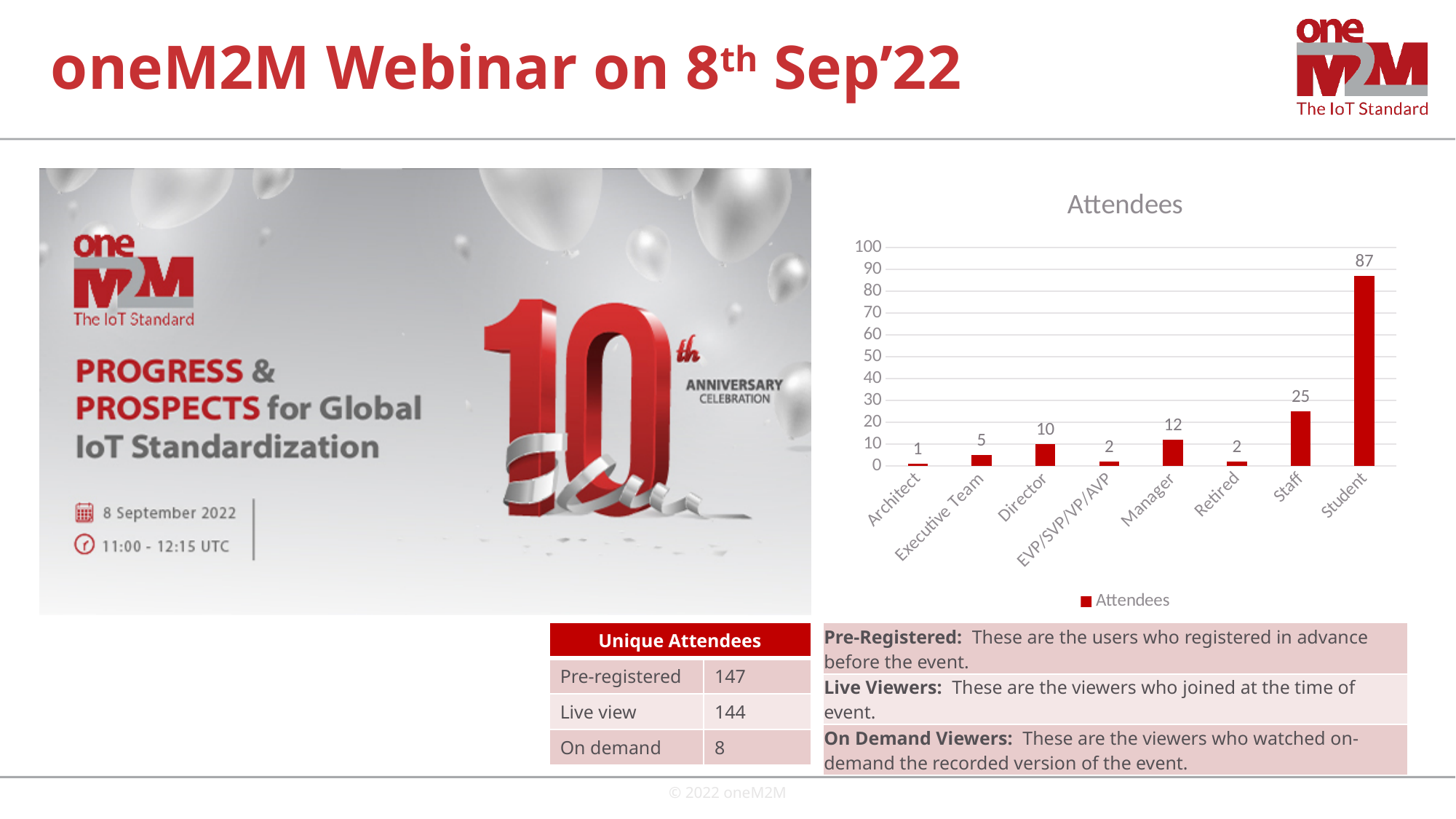
Is the value for Student greater or less than 80? greater What is the difference in attendees between Student and Staff? 62 What is the number of attendees for Staff? 25 Which category has the lowest number of attendees? Architect How many series does the chart legend list? 1 What is the number of attendees for Student? 87 Which has more attendees, Manager or Executive Team? Manager What is the number of attendees for Manager? 12 What is the number of attendees for Director? 10 What type of chart is shown on the slide? Bar chart Which category has the highest number of attendees? Student How many categories are shown on the x axis of the chart? 8